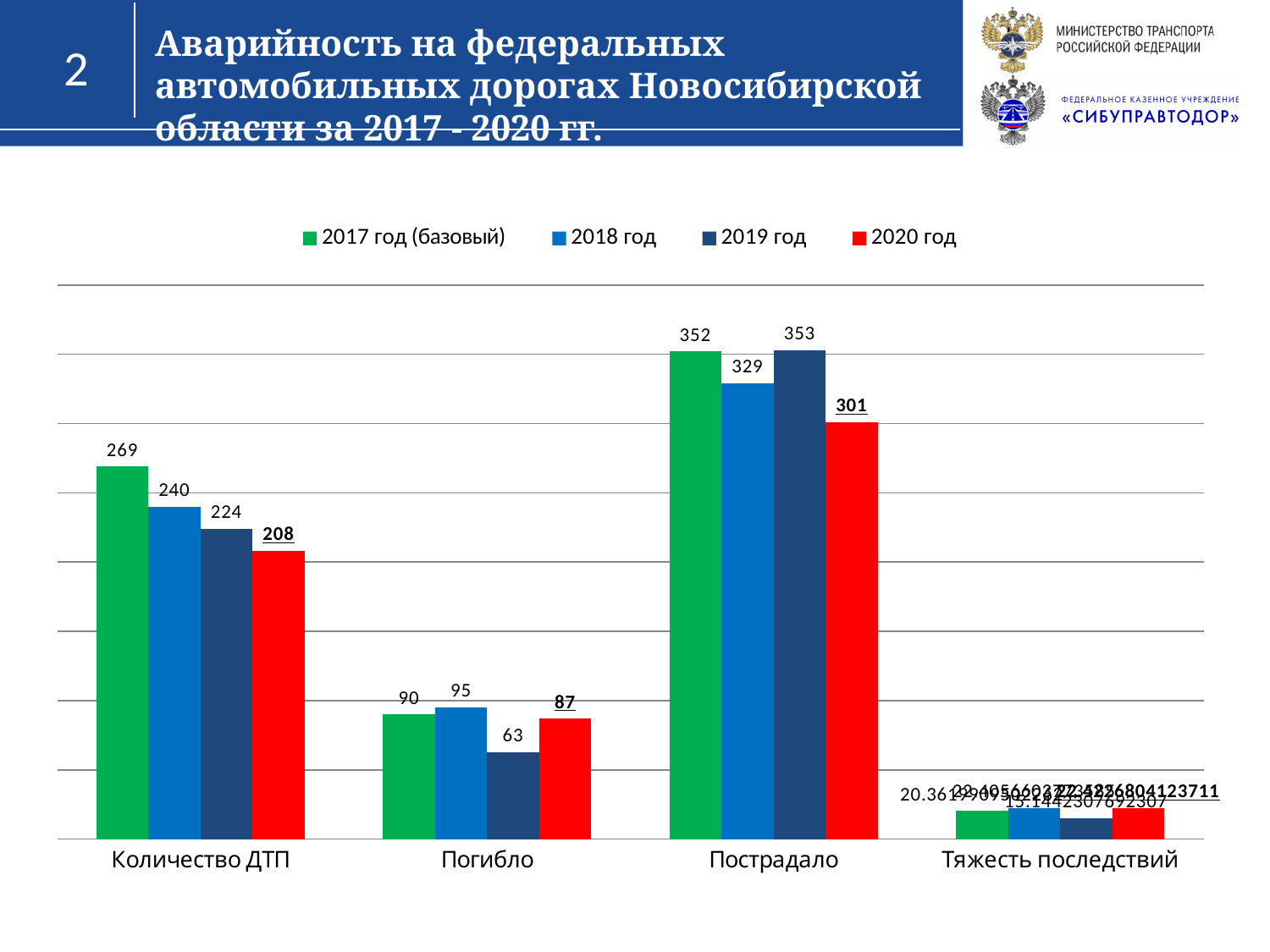
What is the value for 2020 год in the Количество ДТП category? 208 What is the value for 2019 год in the Погибло category? 63 What is the value for 2017 год (базовый) in the Количество ДТП category? 269 How many series does the legend list? 4 How many categories are shown on the x axis? 4 What type of chart is shown on the slide? bar chart Which year has the highest value in the Пострадало category? 2019 год How do the Количество ДТП values change from 2017 год (базовый) to 2020 год? They fall What is the difference between the 2017 год (базовый) and 2020 год values in the Количество ДТП category? 61 What is the value for 2018 год in the Пострадало category? 329 Which is larger in the Погибло category: the value for 2018 год or the value for 2020 год? 2018 год Which year has the lowest value in the Погибло category? 2019 год